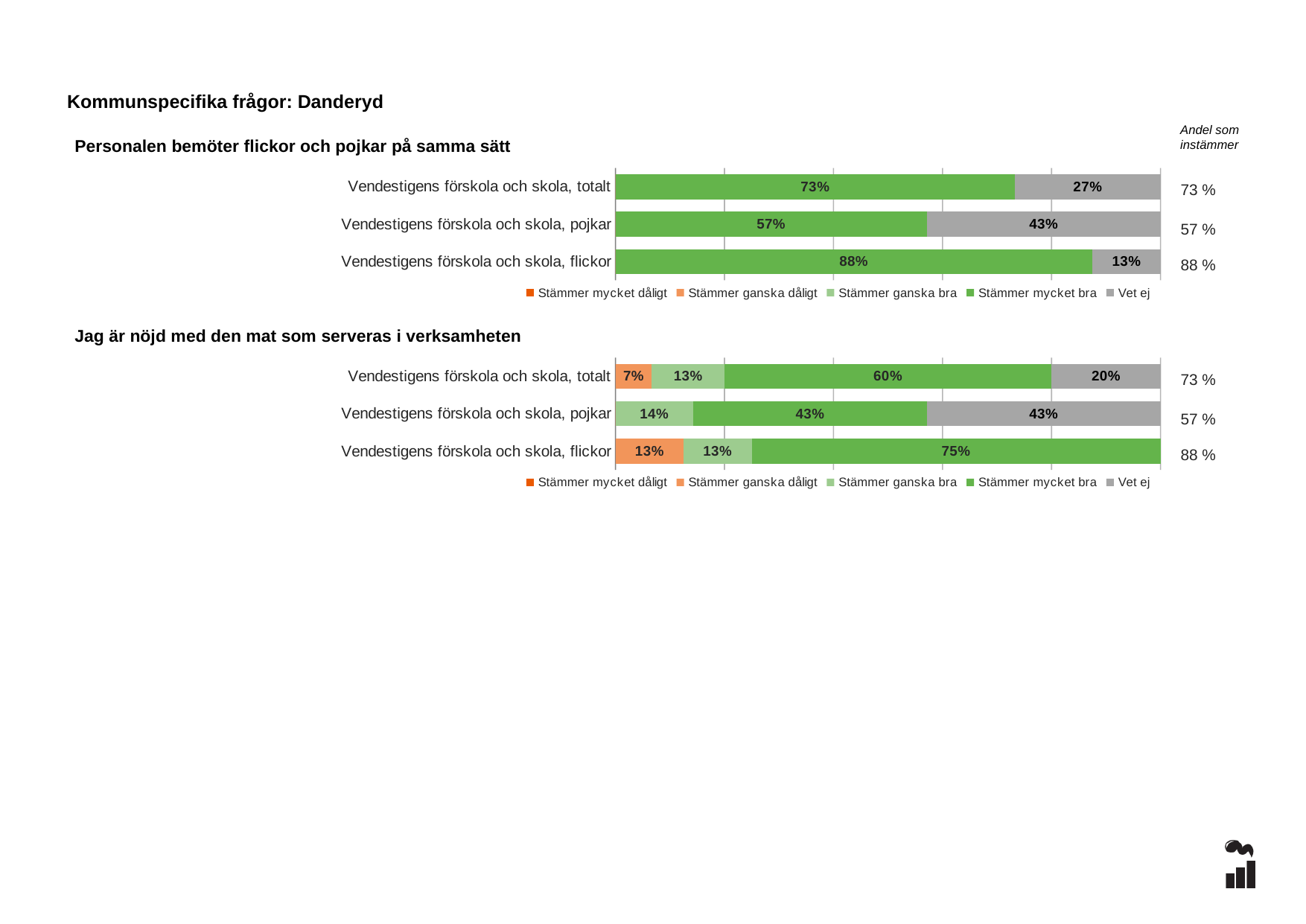
In the chart 'Jag är nöjd med den mat som serveras i verksamheten', what colour represents 'Vet ej'? Grey In the chart 'Personalen bemöter flickor och pojkar på samma sätt', what is the difference between the 'Stämmer mycket bra' values for flickor and pojkar? 31 percentage points In the chart 'Personalen bemöter flickor och pojkar på samma sätt', what is the 'Vet ej' value for 'Vendestigens förskola och skola, pojkar'? 43% In the chart 'Jag är nöjd med den mat som serveras i verksamheten', what is the 'Stämmer mycket bra' value for 'Vendestigens förskola och skola, totalt'? 60% In the chart 'Jag är nöjd med den mat som serveras i verksamheten', what is the 'Stämmer ganska dåligt' value for 'Vendestigens förskola och skola, flickor'? 13% What kind of chart is 'Jag är nöjd med den mat som serveras i verksamheten'? Stacked bar chart In the chart 'Jag är nöjd med den mat som serveras i verksamheten', which category has the lowest 'Stämmer mycket bra' value? Vendestigens förskola och skola, pojkar In the chart 'Personalen bemöter flickor och pojkar på samma sätt', which category has the highest 'Stämmer mycket bra' value? Vendestigens förskola och skola, flickor In the chart 'Personalen bemöter flickor och pojkar på samma sätt', what is the 'Stämmer mycket bra' value for 'Vendestigens förskola och skola, totalt'? 73% How many categories are shown in the chart 'Personalen bemöter flickor och pojkar på samma sätt'? 3 How many series does the legend of the chart 'Jag är nöjd med den mat som serveras i verksamheten' list? 5 In the chart 'Jag är nöjd med den mat som serveras i verksamheten', is the 'Stämmer mycket bra' value for pojkar larger or smaller than the 'Vet ej' value for totalt? larger